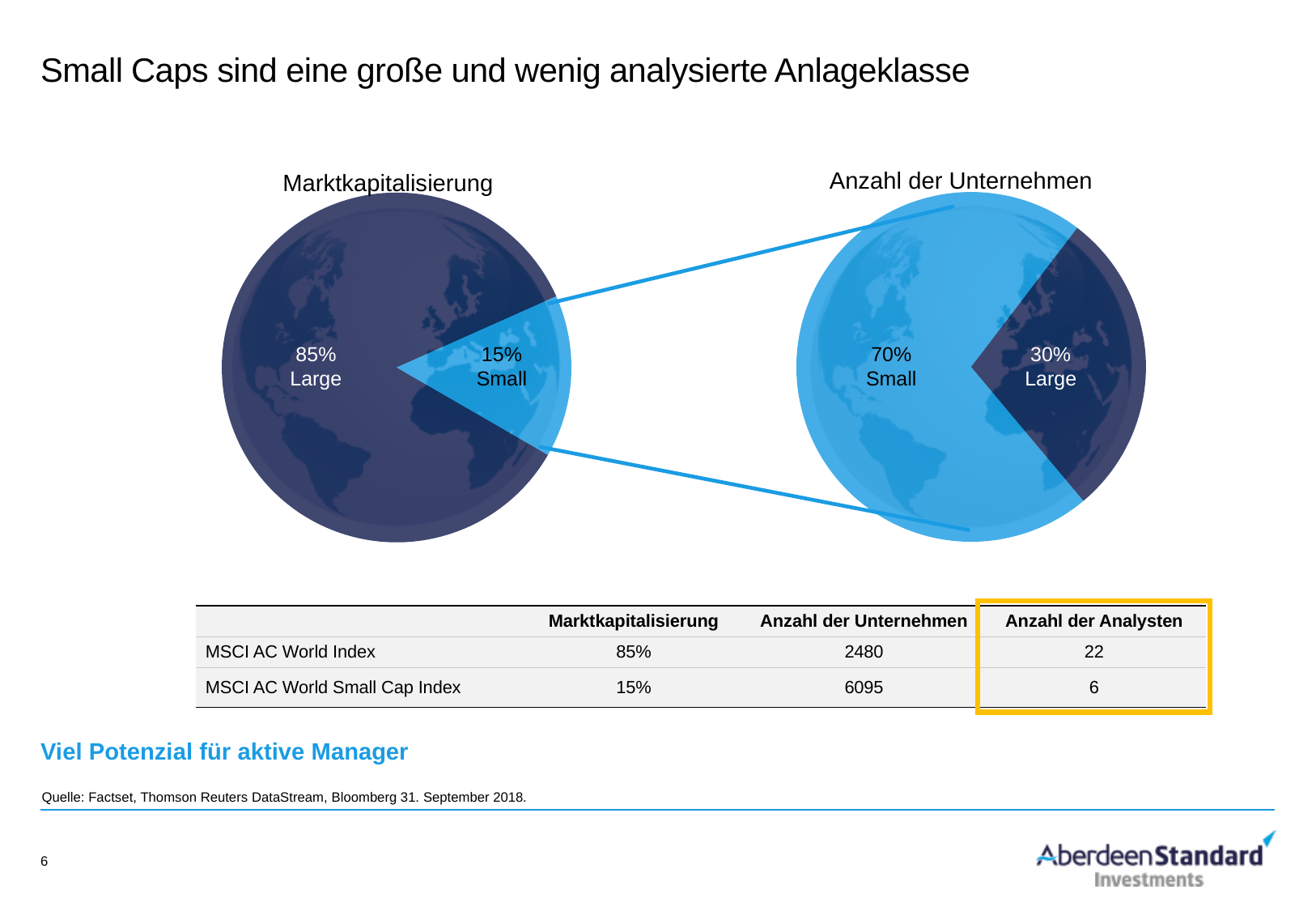
In the Marktkapitalisierung chart, what share is labelled Small? 15% In the Anzahl der Unternehmen chart, what share is labelled Large? 30% In the Anzahl der Unternehmen chart, what share is labelled Small? 70% In the Marktkapitalisierung chart, what share is labelled Large? 85% What kind of chart is the Marktkapitalisierung chart? Pie chart How many slices does the Anzahl der Unternehmen chart have? 2 In the Marktkapitalisierung chart, which slice is the largest? Large In the Anzahl der Unternehmen chart, what is the difference between the Small and Large shares? 40% In the Anzahl der Unternehmen chart, which slice is the smallest? Large How many pie charts are shown on the slide? 2 In the Marktkapitalisierung chart, what is the difference between the Large and Small shares? 70% Is the Small share larger in the Marktkapitalisierung chart or in the Anzahl der Unternehmen chart? Anzahl der Unternehmen